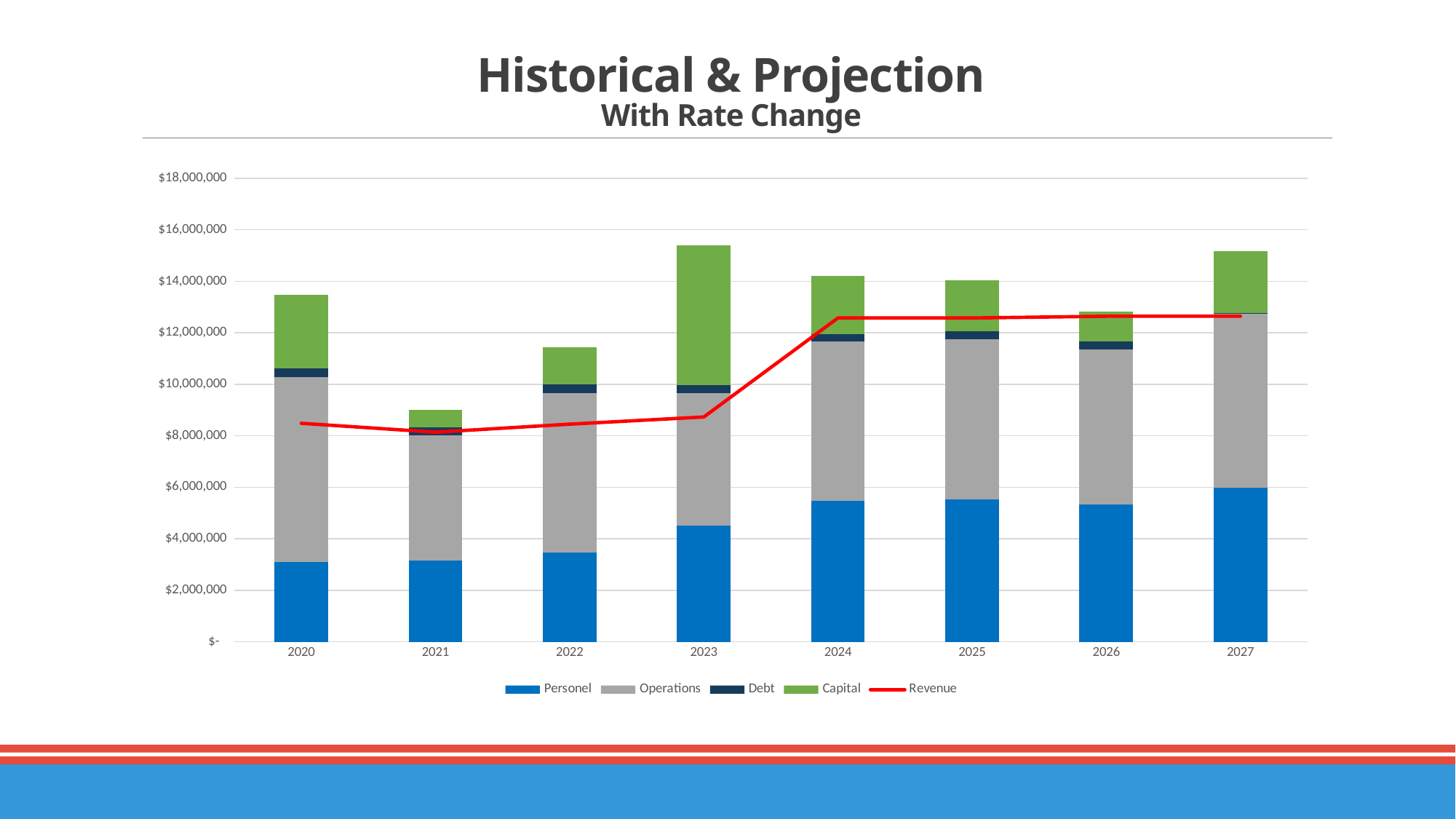
How many years are shown on the x axis of the chart? 8 Which is larger, the total stacked bar for 2021 or for 2022? 2022 Is the Revenue value for 2024 greater or less than $12,000,000? greater Is the Personnel value for 2024 greater or less than $4,000,000? greater Does the Revenue line rise or fall overall from 2020 to 2027? rise Is the total stacked bar for 2023 greater or less than $14,000,000? greater How many series does the chart's legend list? 5 Which year has the lowest total stacked bar? 2021 What kind of chart is shown on the slide? A stacked bar chart with a line series Which is larger, the Capital segment for 2023 or for 2026? 2023